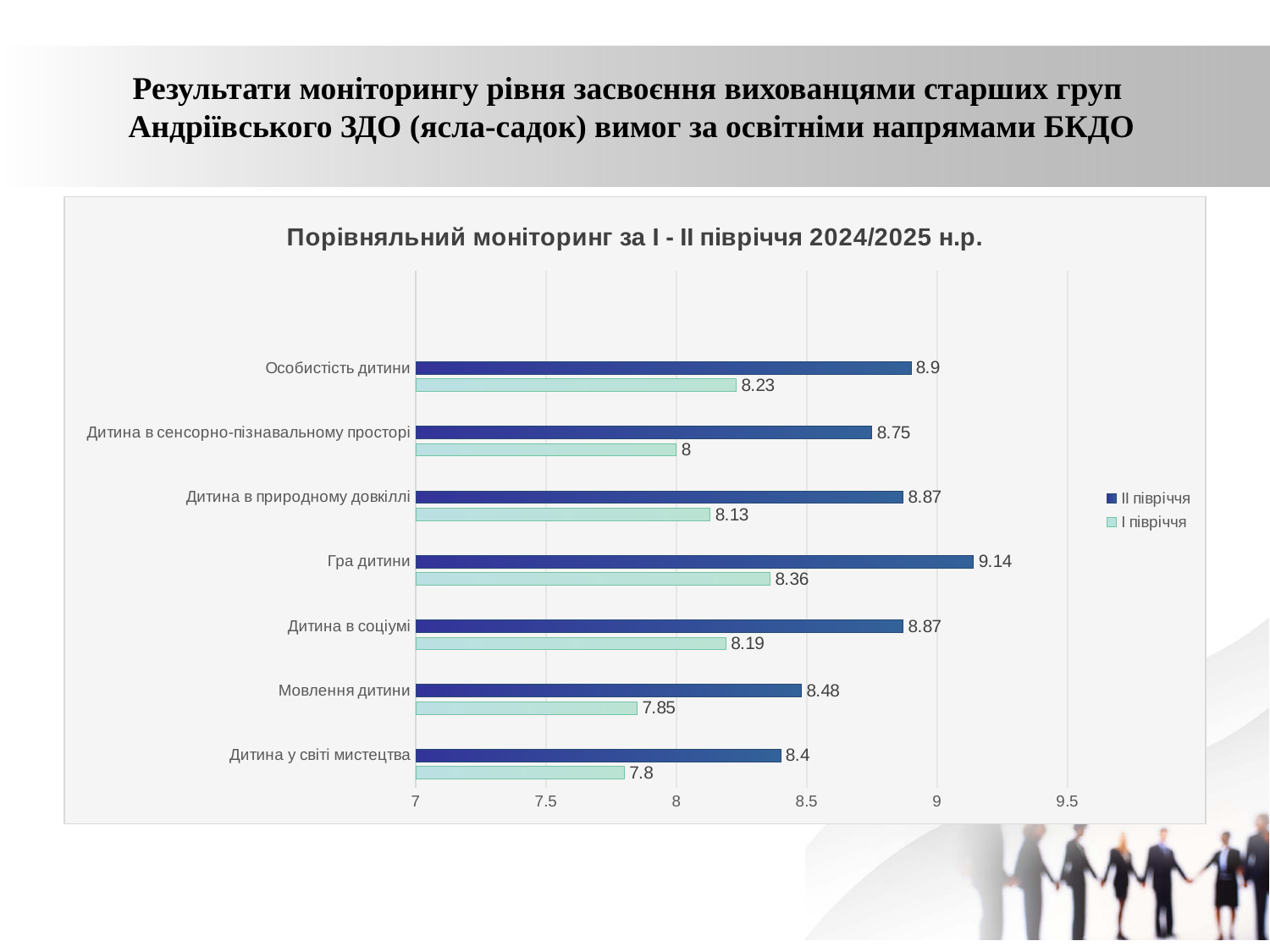
How many categories are plotted on the chart? 7 Which category has the highest value in the "ІІ півріччя" series? Гра дитини What is the value for "Дитина в сенсорно-пізнавальному просторі" in the "І півріччя" series? 8 How many series does the legend list? 2 What type of chart is shown on the slide? bar chart Is the "ІІ півріччя" value for "Дитина у світі мистецтва" greater or less than 9? less What is the difference between the "ІІ півріччя" and "І півріччя" values for "Гра дитини"? 0.78 Which category has the lowest value in the "І півріччя" series? Дитина у світі мистецтва What is the value for "Мовлення дитини" in the "І півріччя" series? 7.85 What is the value for "Гра дитини" in the "ІІ півріччя" series? 9.14 Which is larger for "Особистість дитини": the "ІІ півріччя" value or the "І півріччя" value? ІІ півріччя What is the chart's title? Порівняльний моніторинг за І - ІІ півріччя 2024/2025 н.р.